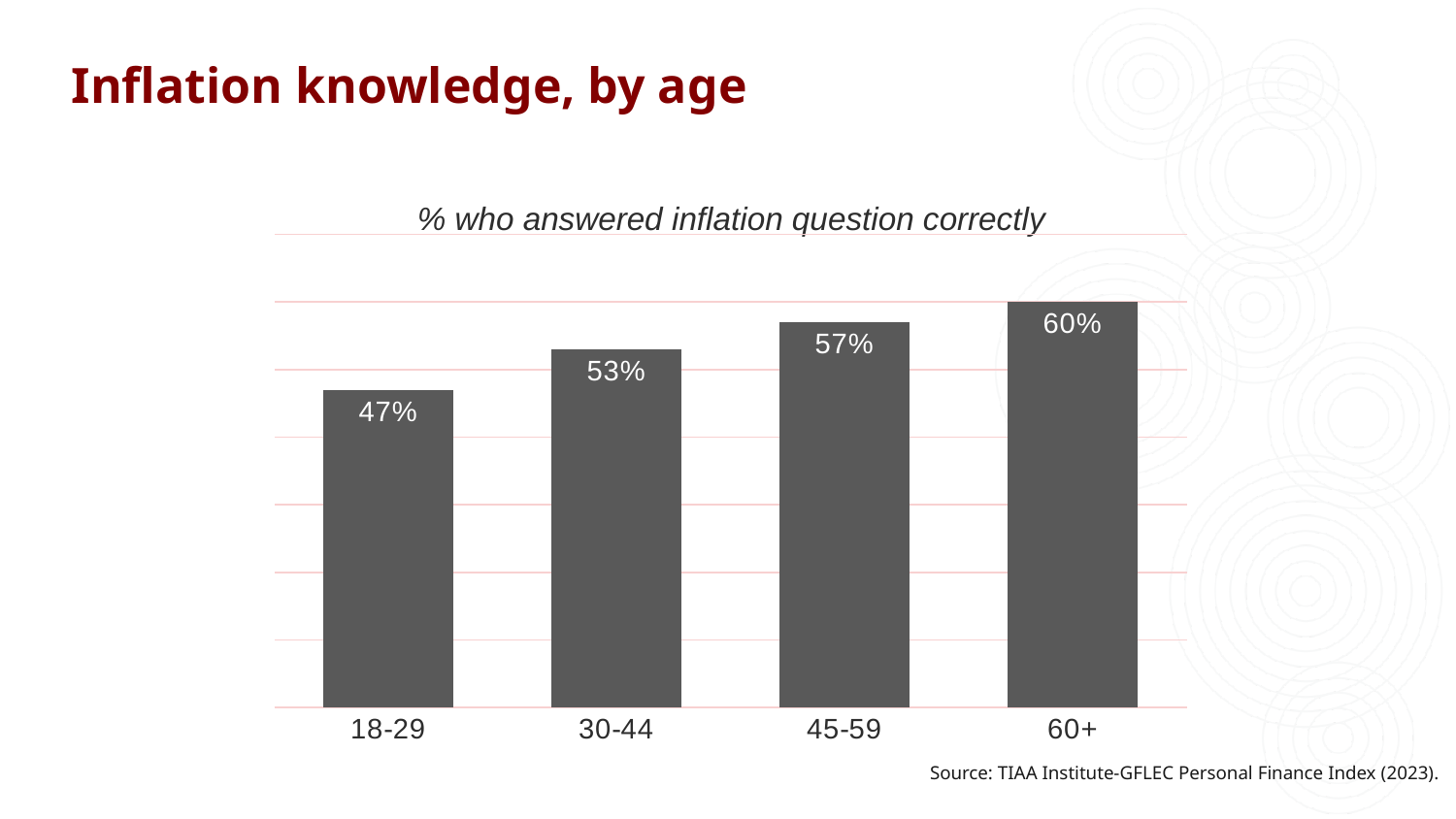
What is the value shown for the 45-59 age group? 57% What is the value shown for the 60+ age group? 60% What is the difference in percentage points between the 60+ group and the 18-29 group? 13 percentage points Which age group has the lowest share answering the inflation question correctly? 18-29 Which is larger, the value for 30-44 or the value for 45-59? 45-59 What is the difference in percentage points between the 45-59 group and the 30-44 group? 4 percentage points Do the values rise or fall as age increases along the x axis? Rise What kind of chart is shown on the slide? Bar chart Which age group has the highest share answering the inflation question correctly? 60+ What percentage of the 18-29 age group answered the inflation question correctly? 47% How many age groups are shown in the chart? 4 What is the value shown for the 30-44 age group? 53%